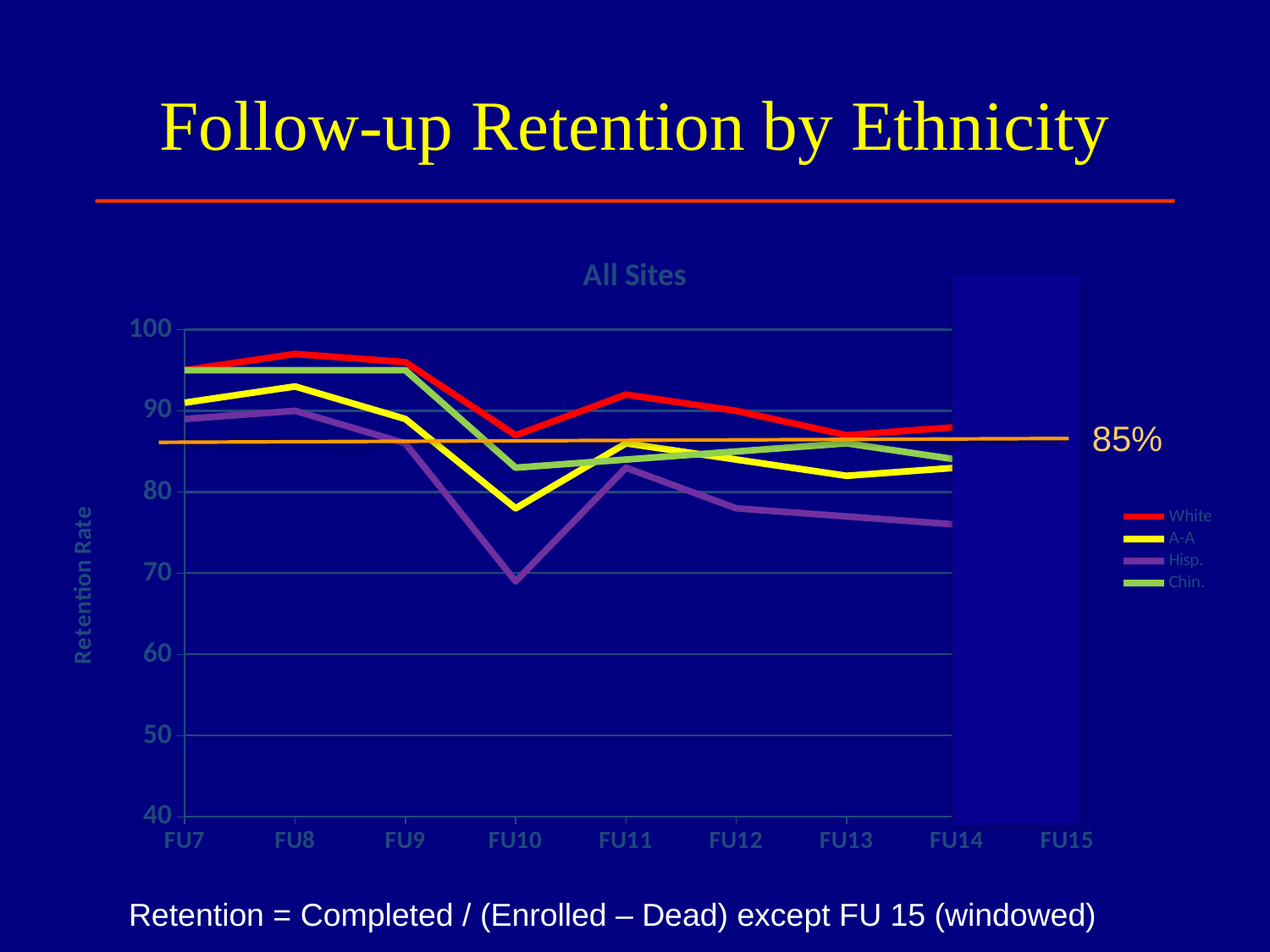
Does the retention rate for Hisp. rise or fall from FU11 to FU14? fall Is the retention rate for A-A at FU10 greater or less than 80? less Is the retention rate for Chin. at FU7 greater or less than 90? greater Is the retention rate for White at FU8 greater or less than 90? greater How many series does the legend list? 4 At FU14, which has the higher retention rate, White or Hisp.? White Which ethnic group has the highest retention rate at FU8? White Which ethnic group has the lowest retention rate at FU10? Hisp. What value is marked by the horizontal reference line on the chart? 85% What kind of chart is shown on the slide? line chart How many follow-up visits are labeled on the x axis? 9